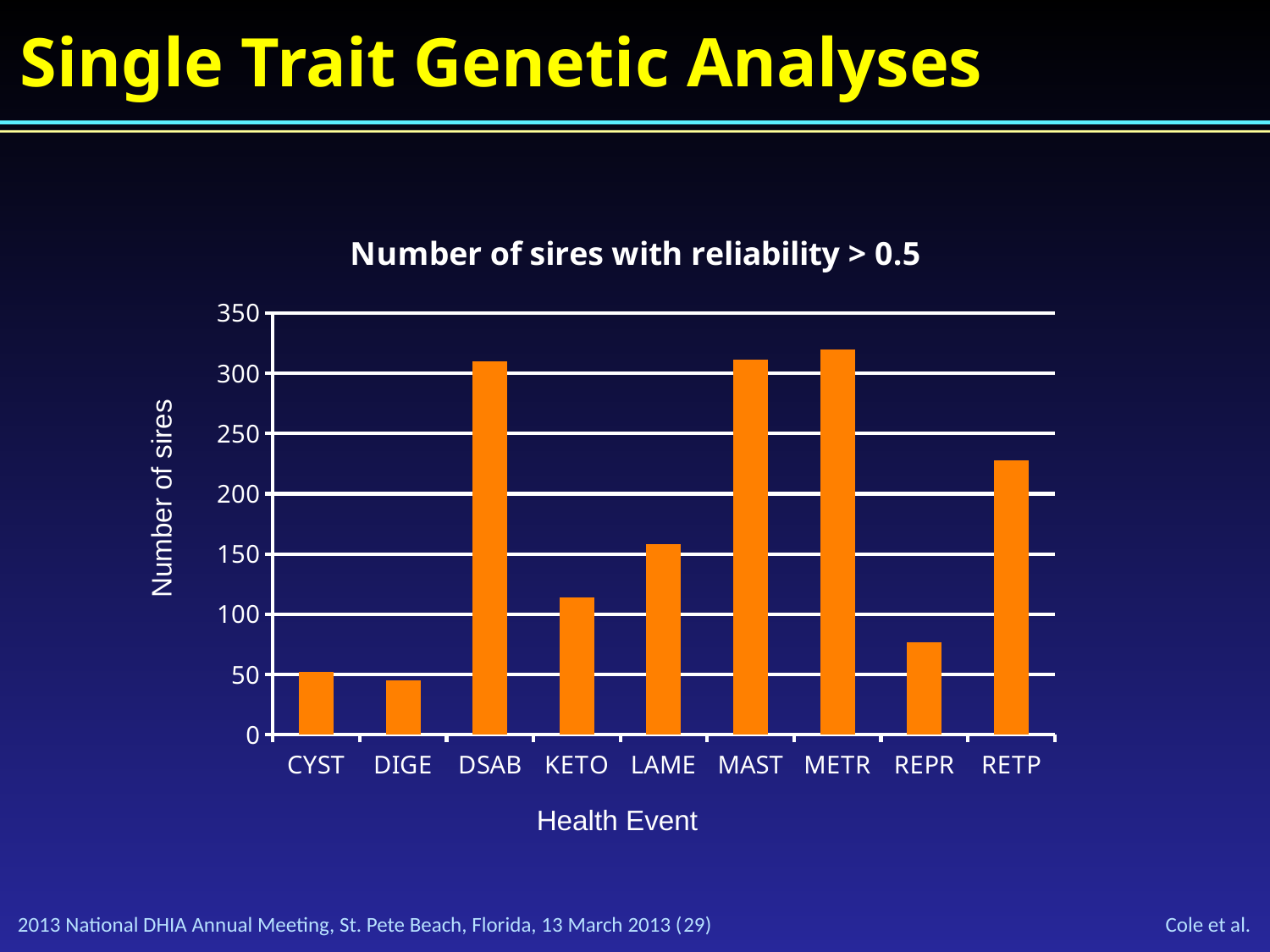
What is the label of the y axis? Number of sires How many health events are shown on the x axis of the chart? 9 Is the value for REPR greater or less than 100? less Is the value for METR greater or less than 250? greater What is the title of the chart? Number of sires with reliability > 0.5 Is the value for CYST greater or less than 100? less What kind of chart is shown on the slide? Bar chart Which has more sires, REPR or CYST? REPR Which has more sires, DSAB or KETO? DSAB Which has more sires, RETP or LAME? RETP